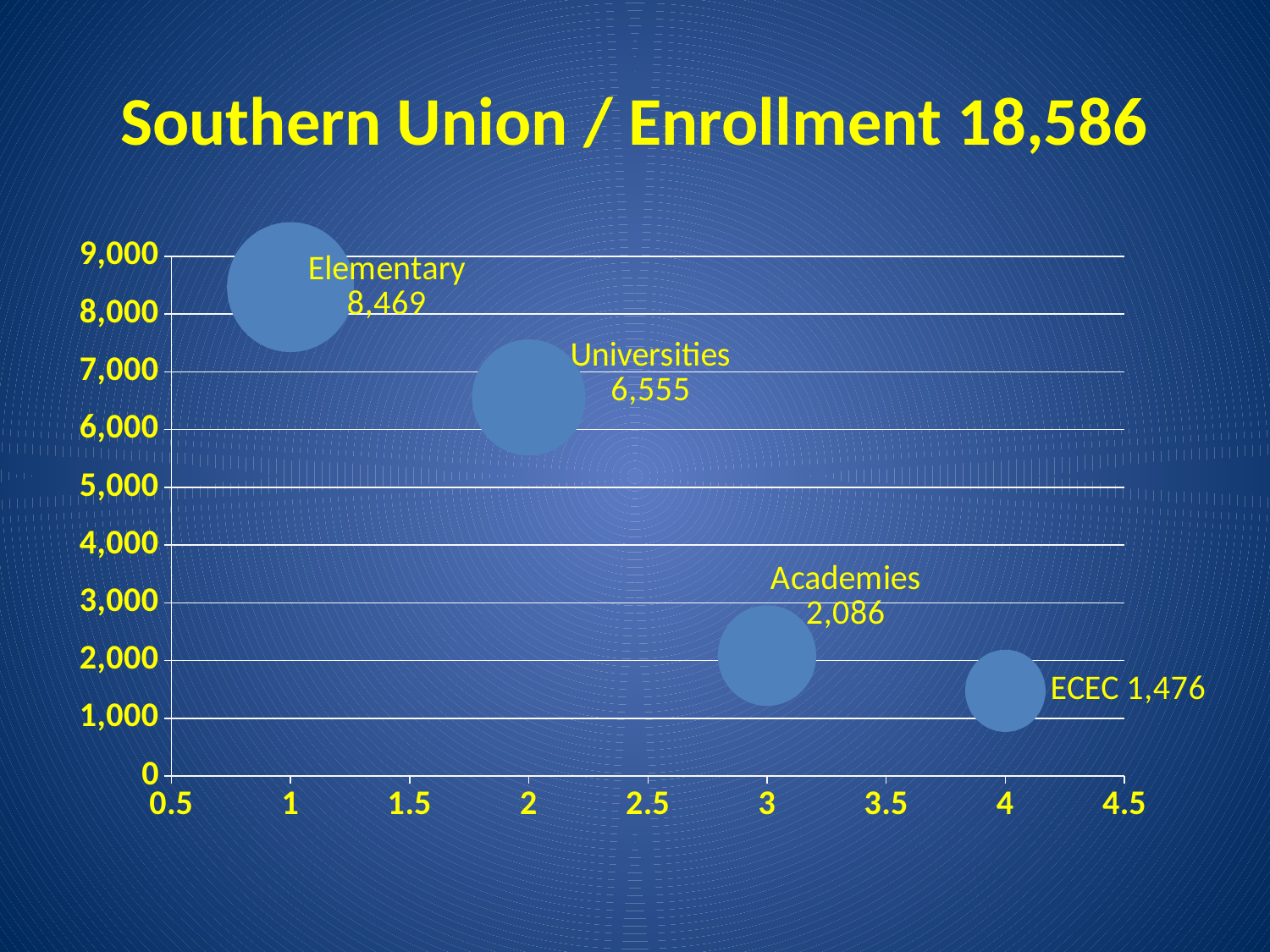
What is the title of the slide? Southern Union / Enrollment 18,586 What kind of chart is shown on the slide? Bubble chart What is the enrollment value shown for Universities? 6,555 Which category has the lowest enrollment? ECEC What is the enrollment value shown for ECEC? 1,476 Which has a larger enrollment, Universities or Academies? Universities How many categories are plotted on the chart? 4 What is the enrollment value shown for Academies? 2,086 What is the difference in enrollment between Academies and ECEC? 610 Which category has the highest enrollment? Elementary What is the difference in enrollment between Elementary and Universities? 1,914 What is the enrollment value shown for Elementary? 8,469